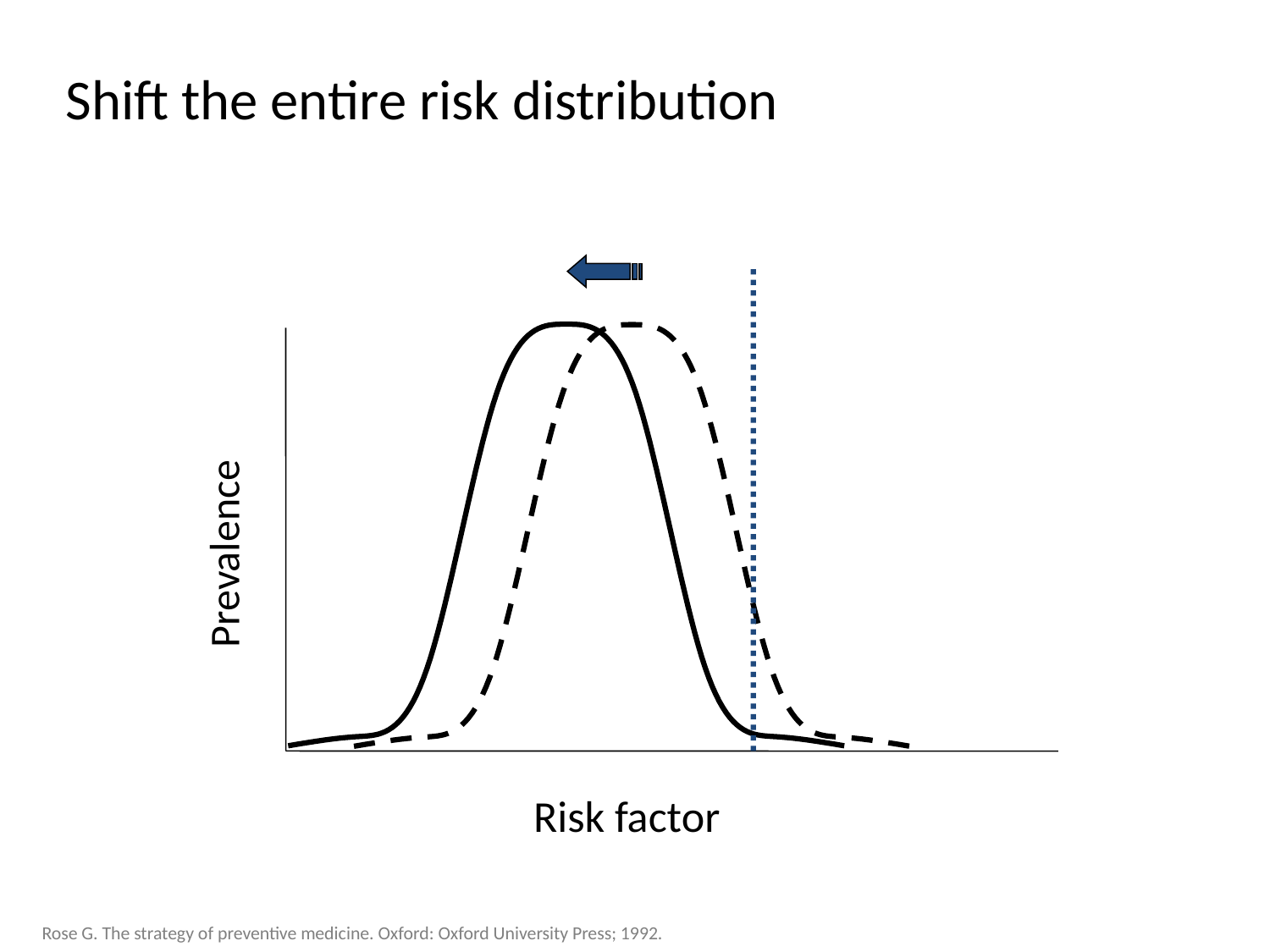
Which curve peaks further to the right along the x axis, the solid curve or the dashed curve? the dashed curve What is the label of the y axis? Prevalence Which curve lies further to the left along the x axis, the solid curve or the dashed curve? the solid curve What kind of chart is shown on the slide? line chart How many curves are plotted on the chart? 2 What is the label of the x axis? Risk factor